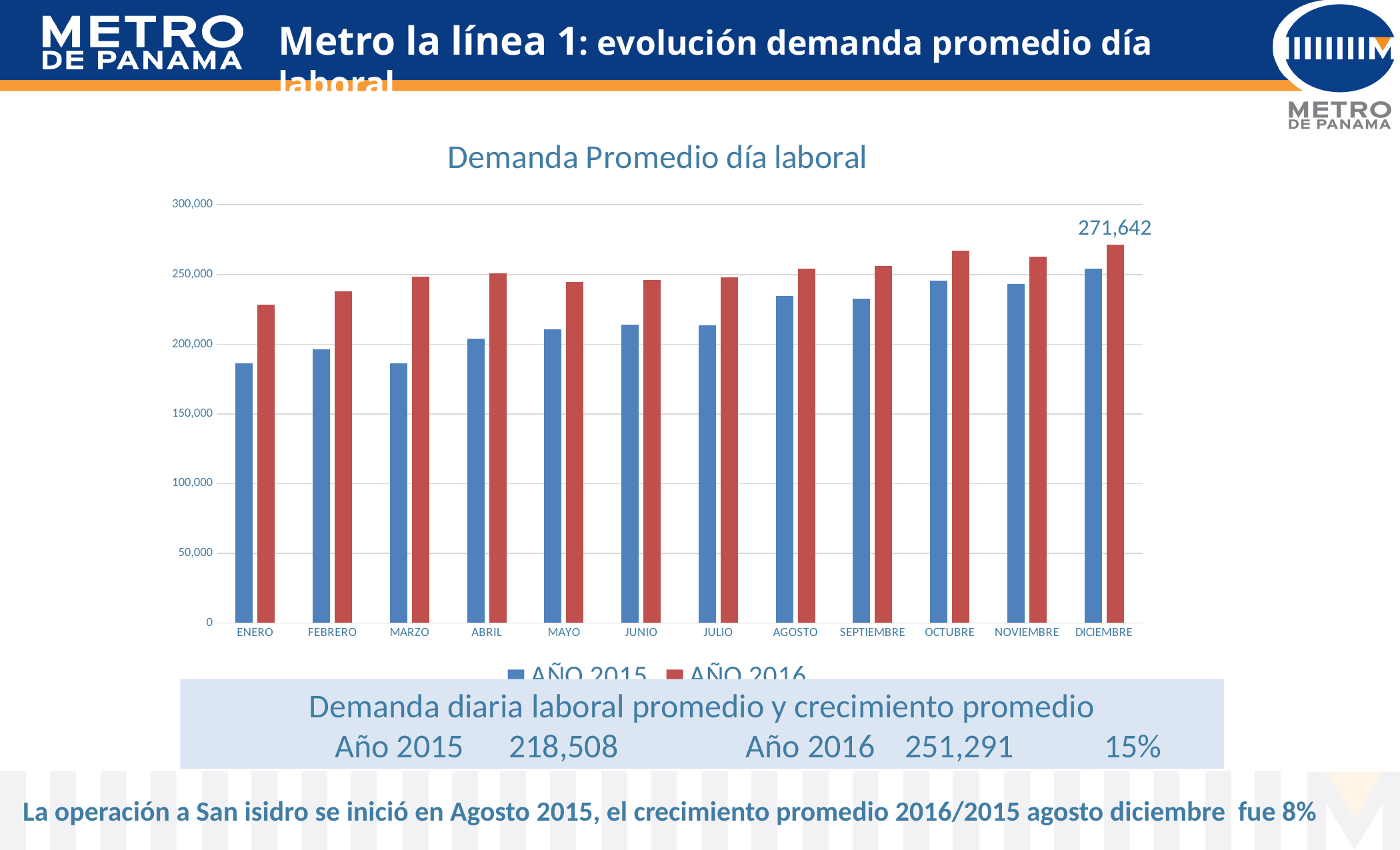
How many months are shown on the x axis of the chart? 12 Which month has the lowest AÑO 2016 value? ENERO For ENERO, which series has the larger value, AÑO 2015 or AÑO 2016? AÑO 2016 How many series does the legend of the chart list? 2 Which month has the highest AÑO 2016 value? DICIEMBRE Is the AÑO 2015 value for ENERO greater or less than 200,000? less What kind of chart is shown on the slide? bar chart Is the AÑO 2016 value for OCTUBRE greater or less than 250,000? greater Do the AÑO 2016 values generally rise or fall from ENERO to DICIEMBRE? rise What is the title of the chart? Demanda Promedio día laboral What is the AÑO 2016 value for DICIEMBRE? 271,642 Which month has the highest AÑO 2015 value? DICIEMBRE